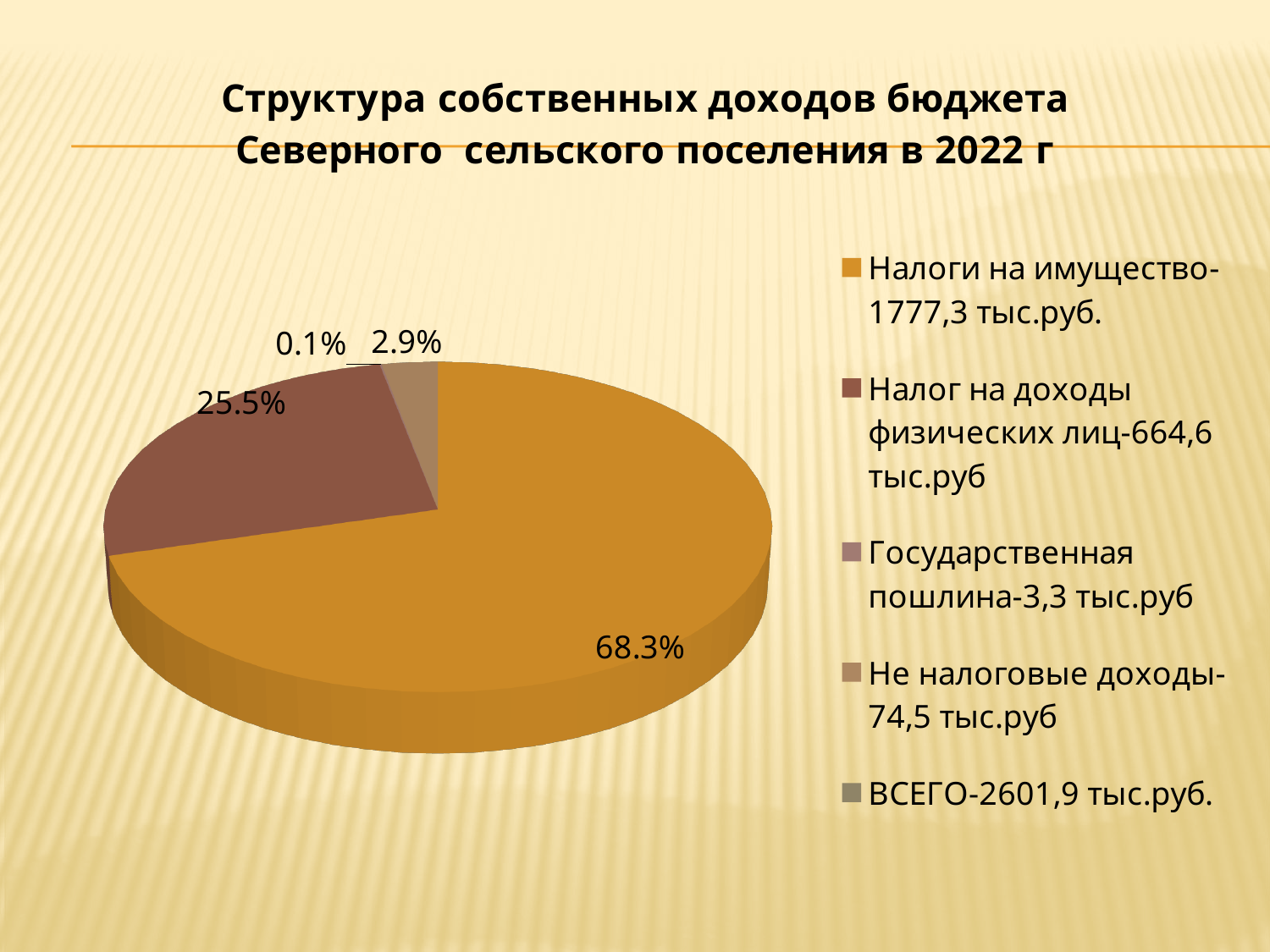
What share of the pie is labelled for Налоги на имущество? 68.3% What is the difference in percentage points between the Налоги на имущество slice and the Налог на доходы физических лиц slice? 42.8 Which category has the smallest slice of the pie? Государственная пошлина How many percentage labels are shown on the pie? 4 What share of the pie is labelled for Не налоговые доходы? 2.9% How many entries does the legend list? 5 What share of the pie is labelled for Государственная пошлина? 0.1% What kind of chart is shown on the slide? pie chart Which category has the largest slice of the pie? Налоги на имущество Which slice is larger: Не налоговые доходы or Государственная пошлина? Не налоговые доходы According to the legend, what is the total (ВСЕГО) amount of own budget revenues? 2601,9 тыс.руб.